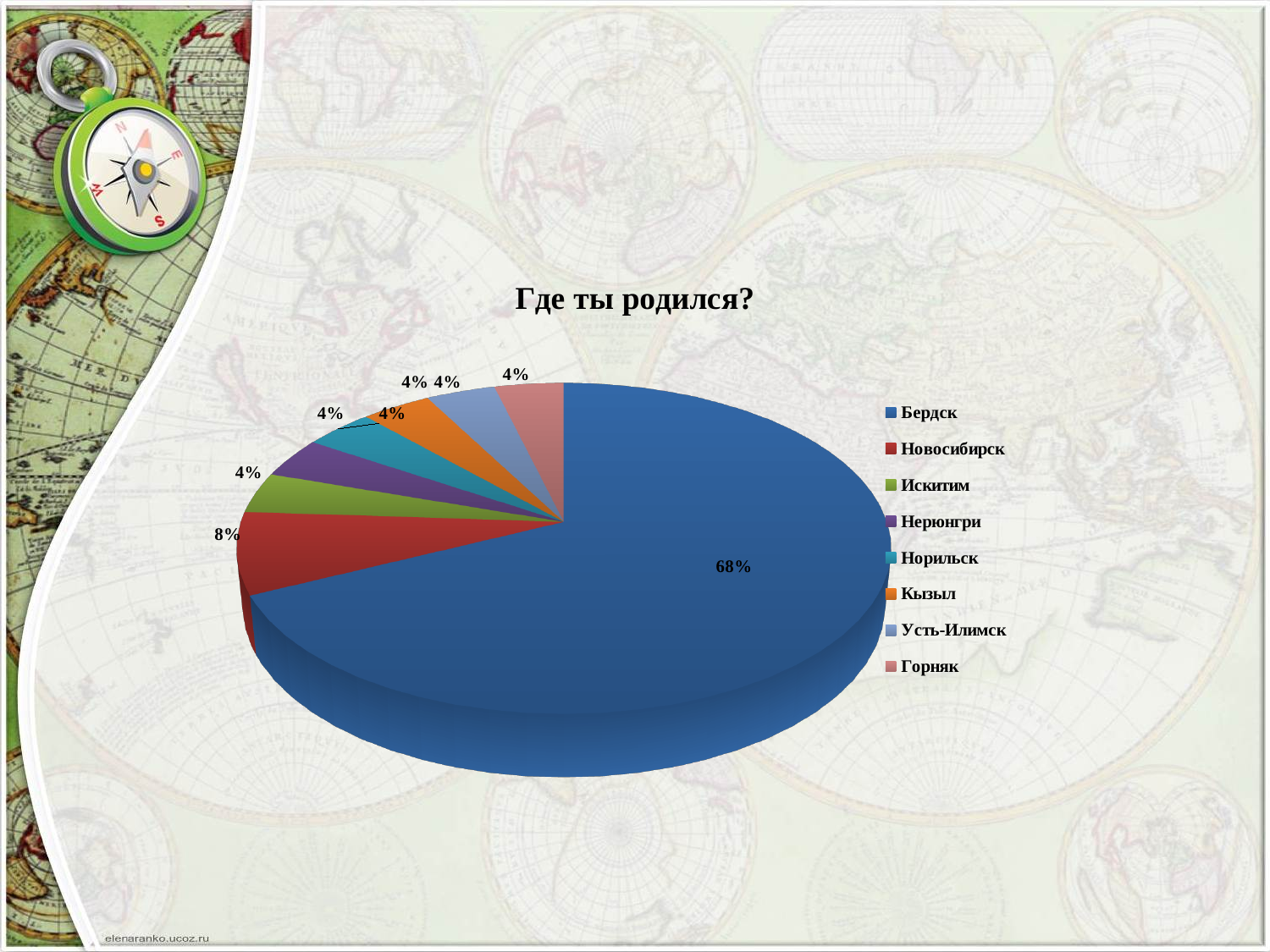
Which category is shown in the last (bottom) entry of the legend? Горняк How many categories have a share of 4%? 6 Which is larger, the slice for Новосибирск or the slice for Горняк? Новосибирск What type of chart is shown on the slide? pie chart How many categories does the legend of the pie chart list? 8 What is the difference in percentage points between Бердск and Новосибирск? 60 What share of the pie does Новосибирск have? 8% Which category has the largest slice of the pie? Бердск Which category has the second largest slice of the pie? Новосибирск What is the title of the chart? Где ты родился? What share of the pie does Бердск have? 68% What share of the pie does Искитим have? 4%